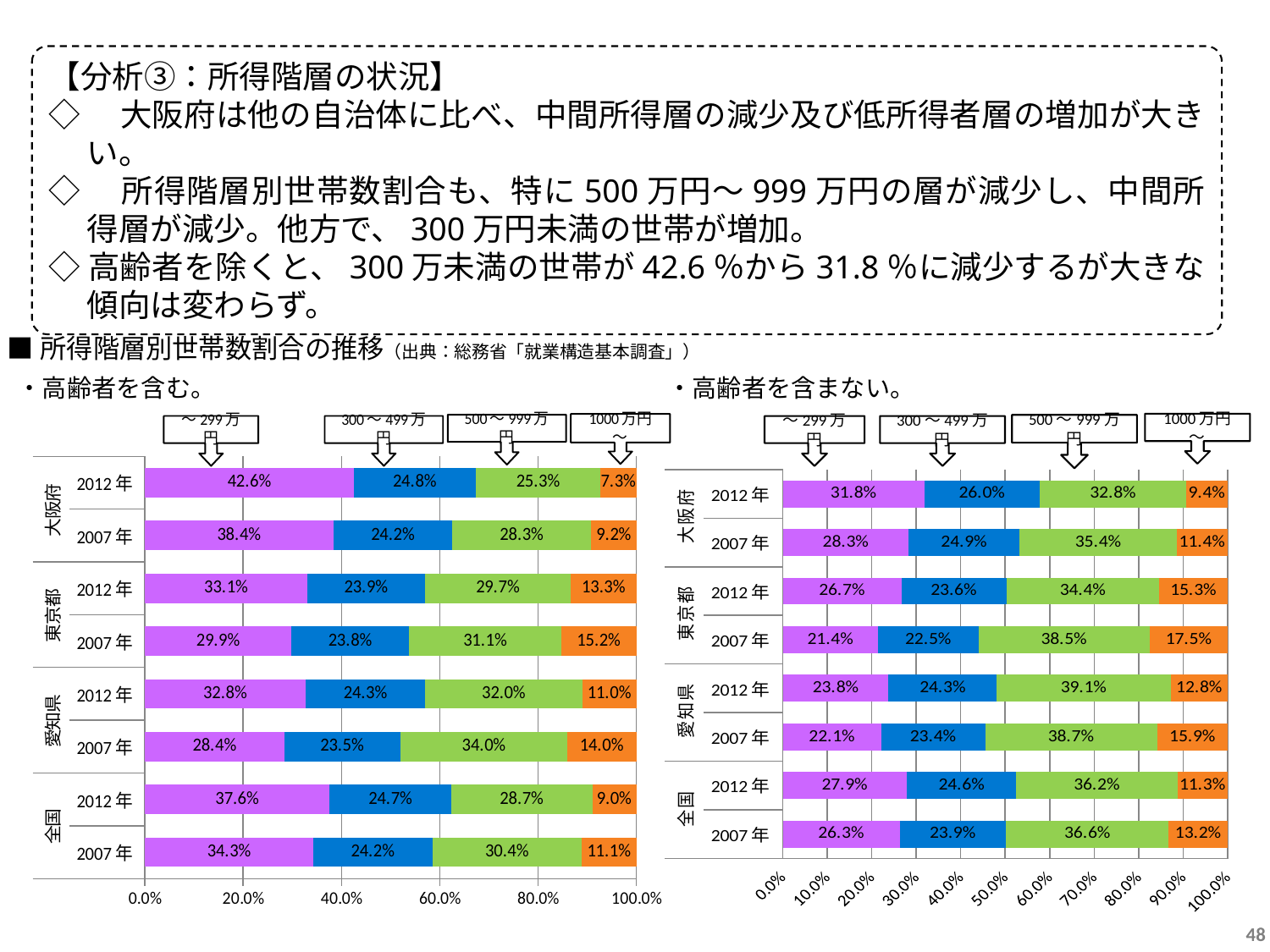
How many bars are plotted in the right chart (高齢者を含まない)? 8 In the right chart (高齢者を含まない), what is the value for 500～999万円 for 愛知県 in 2012年? 39.1% In the left chart (高齢者を含む), what is the combined value of ～299万円 and 300～499万円 for 全国 in 2007年? 58.5% In the left chart (高齢者を含む), what is the value for 1000万円～ for 東京都 in 2007年? 15.2% In the left chart (高齢者を含む), what is the difference between the ～299万円 values for 大阪府 in 2012年 and 2007年? 4.2% In the left chart (高齢者を含む), which bar has the highest value for ～299万円? 大阪府 2012年 In the right chart (高齢者を含まない), which bar has the lowest value for ～299万円? 東京都 2007年 What kind of chart is the left chart (高齢者を含む)? Stacked bar chart How many series does the legend of the left chart (高齢者を含む) list? 4 In the right chart (高齢者を含まない), which is larger for 全国 in 2012年: the 300～499万円 value or the 1000万円～ value? 300～499万円 In the right chart (高齢者を含まない), what is the value for ～299万円 for 大阪府 in 2012年? 31.8% In the left chart (高齢者を含む), what is the value for ～299万円 for 大阪府 in 2012年? 42.6%